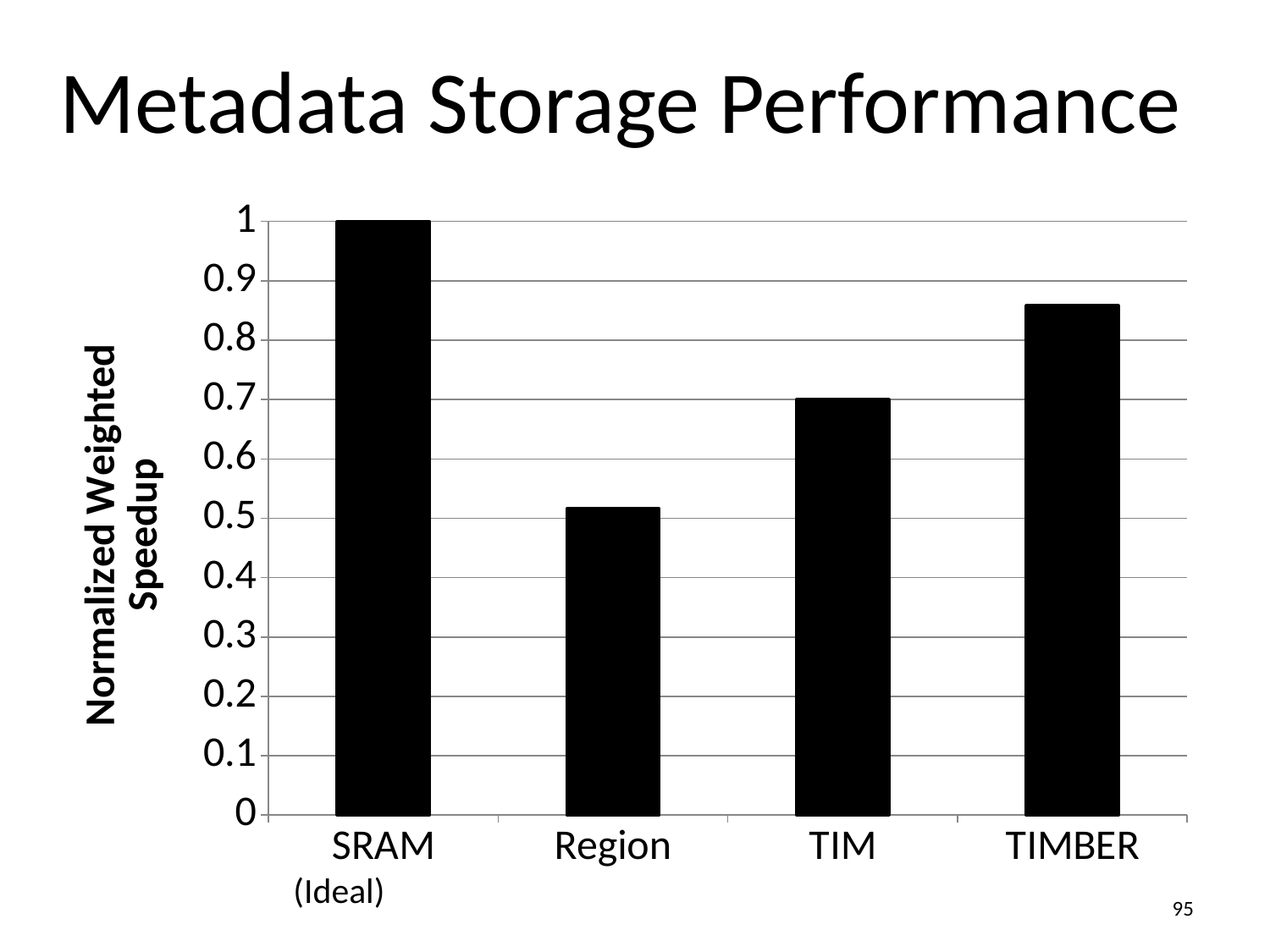
Which has a higher normalized weighted speedup, Region or TIM? TIM What is the normalized weighted speedup for SRAM (Ideal)? 1 Is the value for TIM greater or less than 0.6? greater Is the value for Region greater or less than 0.6? less What is the label on the y axis? Normalized Weighted Speedup Which has a higher normalized weighted speedup, TIM or TIMBER? TIMBER Which category has the lowest normalized weighted speedup? Region How many categories are plotted on the x axis? 4 Which category has the highest normalized weighted speedup? SRAM (Ideal) Is the value for TIMBER greater or less than 0.8? greater What is the title of the slide containing the chart? Metadata Storage Performance What kind of chart is shown on the slide? bar chart